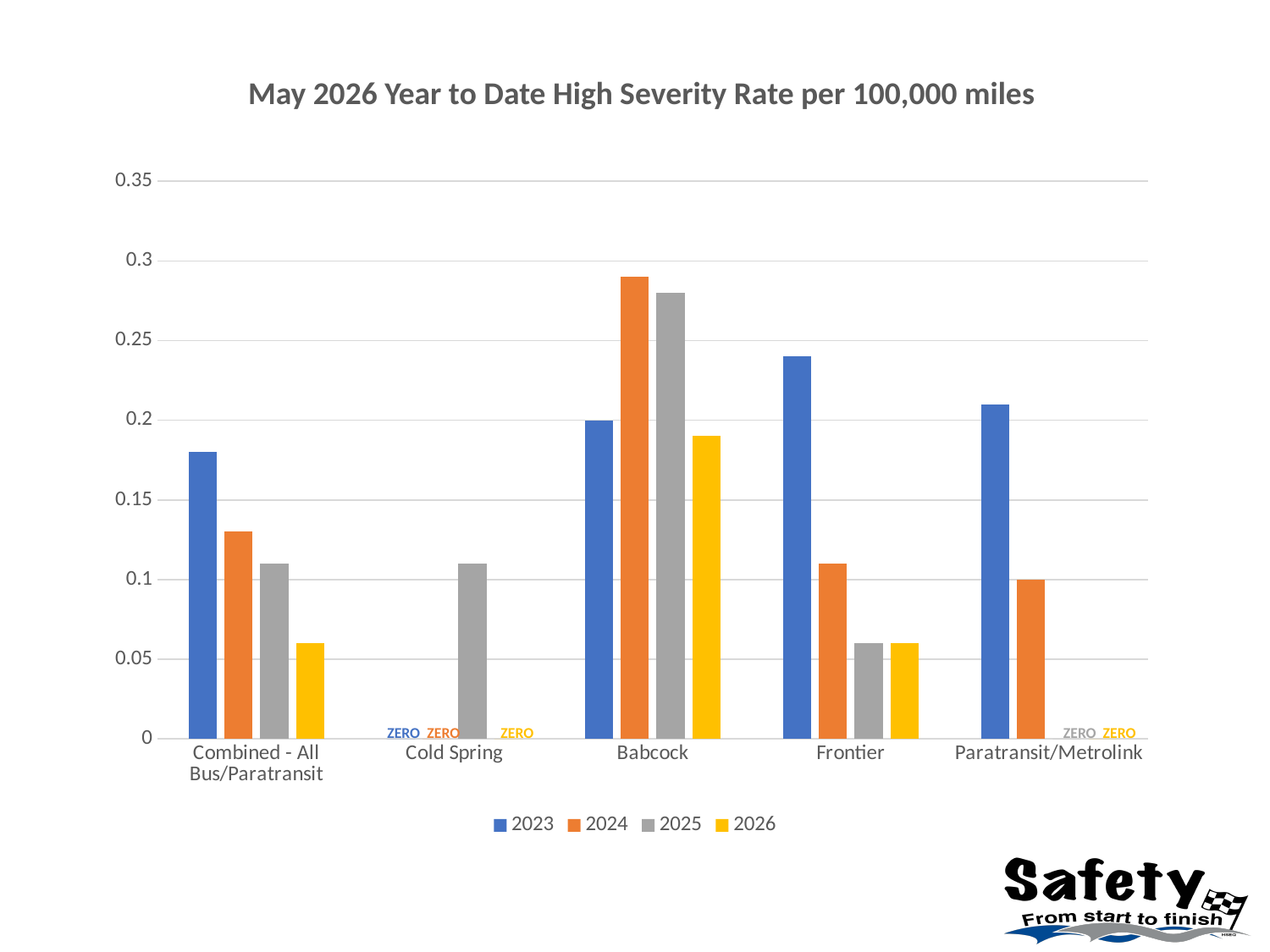
Which is larger, the 2023 value for Frontier or the 2023 value for Paratransit/Metrolink? Frontier Which series has the highest value for Babcock? 2024 What is the title of the chart? May 2026 Year to Date High Severity Rate per 100,000 miles How many series does the legend list? 4 Do the values for Combined - All Bus/Paratransit rise or fall from 2023 to 2026? fall What is the 2025 value for Paratransit/Metrolink? ZERO What type of chart is shown on the slide? bar chart Which category has the highest 2024 value? Babcock Is the 2024 value for Babcock greater or less than 0.25? greater What is the 2024 value for Cold Spring? ZERO How many categories are shown on the x axis? 5 Is the 2023 value for Combined - All Bus/Paratransit greater or less than 0.15? greater